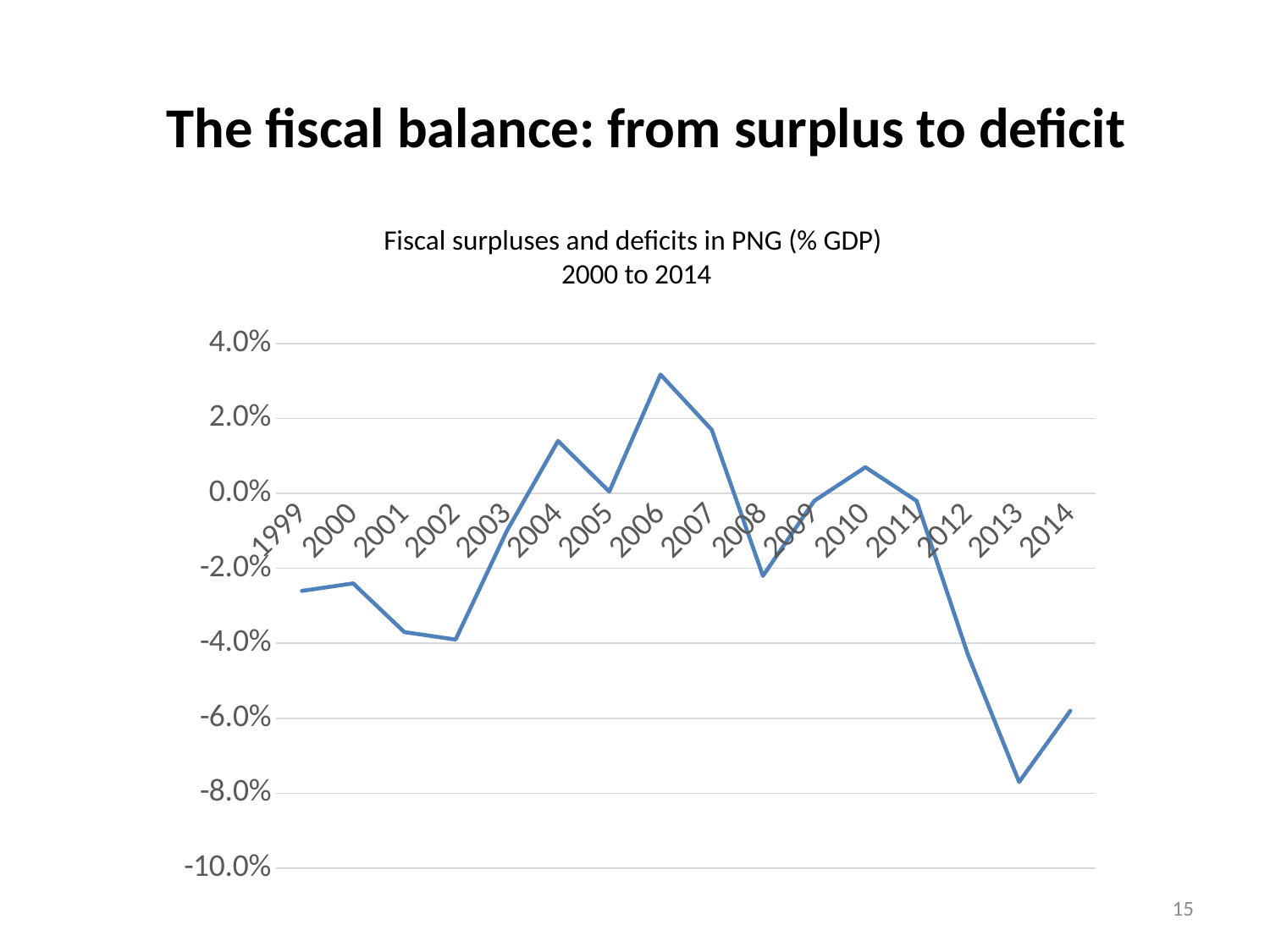
Which year has the lowest fiscal balance in the chart? 2013 Is the value for 2006 greater or less than 2.0%? greater How many years are plotted on the x axis of the chart? 16 Is the value for 2002 greater or less than -2.0%? less Is the value for 2010 greater or less than 0.0%? greater Which year has the highest fiscal balance in the chart? 2006 Which year has the larger fiscal balance, 2004 or 2008? 2004 Does the fiscal balance rise or fall from 2011 to 2013? fall What is the title of the chart? Fiscal surpluses and deficits in PNG (% GDP) 2000 to 2014 Which year has the larger fiscal balance, 2012 or 2014? 2012 What kind of chart is shown on the slide? line chart